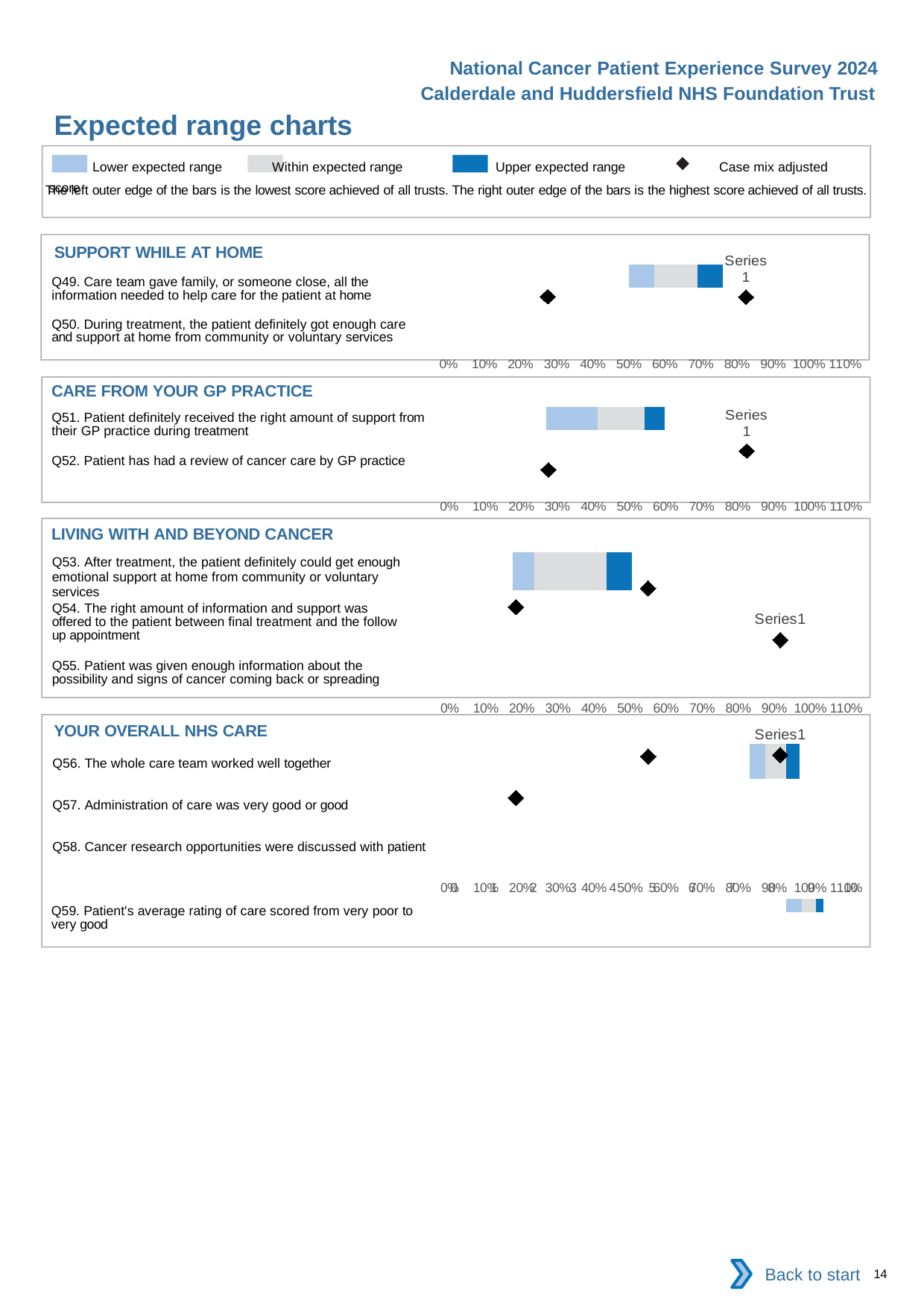
What kind of chart is used in the SUPPORT WHILE AT HOME section? bar chart In the CARE FROM YOUR GP PRACTICE chart, is the leftmost diamond marker greater or less than 40%? less How many diamond markers are plotted in the SUPPORT WHILE AT HOME chart? 2 How many questions are listed in the YOUR OVERALL NHS CARE chart? 4 According to the legend, what does the diamond marker represent? Case mix adjusted score In the LIVING WITH AND BEYOND CANCER chart, is the leftmost diamond marker greater or less than 30%? less In the SUPPORT WHILE AT HOME chart, is the rightmost diamond marker greater or less than 70%? greater How many questions are listed in the LIVING WITH AND BEYOND CANCER chart? 3 How many entries does the legend at the top of the slide list? 4 What is the highest tick label on the x axis of the SUPPORT WHILE AT HOME chart? 110%